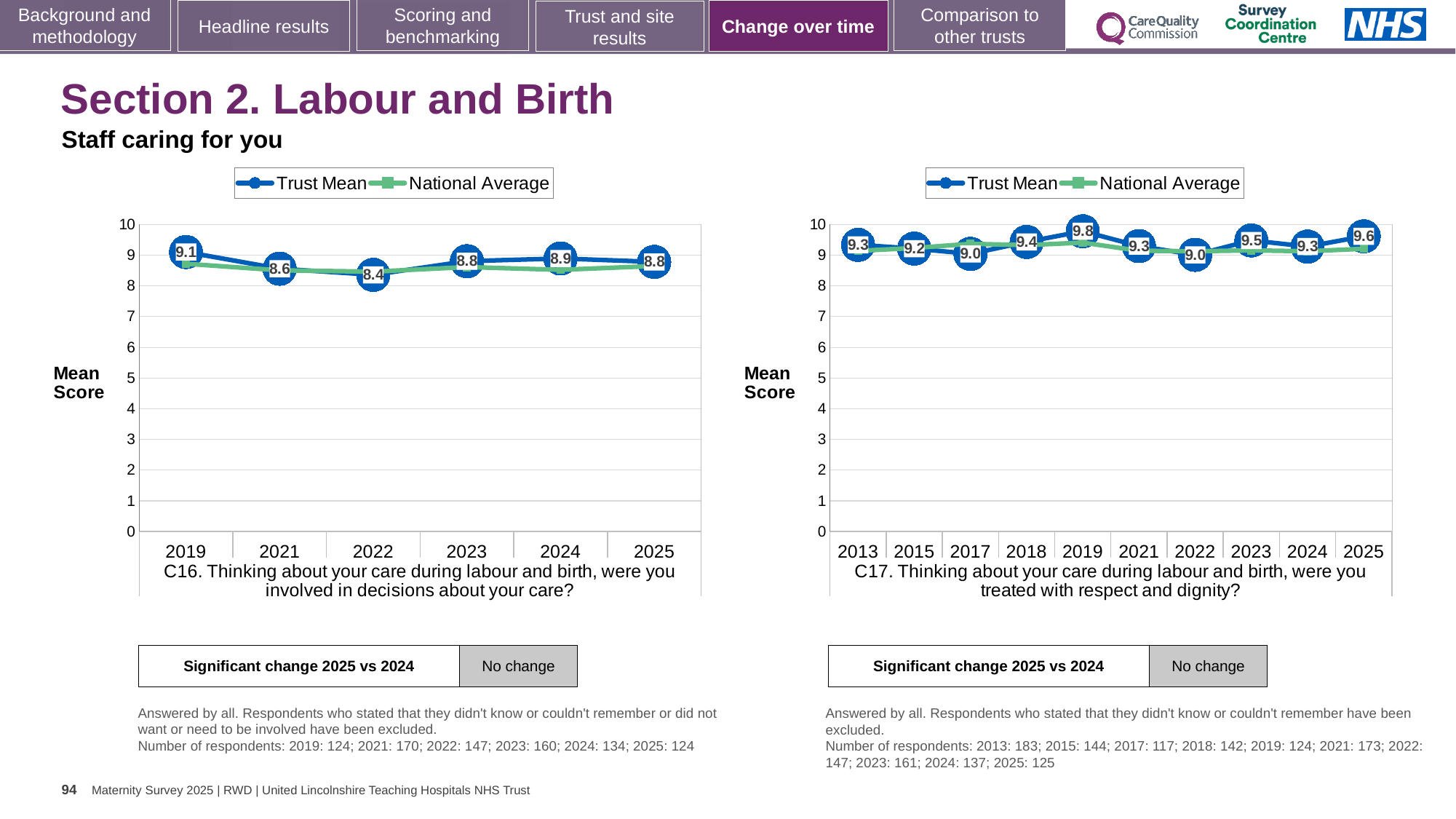
What type of chart is the C16 chart on the left? Line chart In the C17 chart (right), how many series does the legend list? 2 In the C17 chart (right), what is the Trust Mean for 2019? 9.8 In the C16 chart (left), which year has the lowest Trust Mean? 2022 In the C17 chart (right), what is the difference between the Trust Mean for 2025 and 2024? 0.3 In the C17 chart (right), which year has the highest Trust Mean? 2019 In the C16 chart (left), how many years are plotted on the x axis? 6 In the C16 chart (left), what is the difference between the Trust Mean for 2019 and 2022? 0.7 In the C16 chart (left), what is the Trust Mean for 2019? 9.1 In the C16 chart (left), what is the Trust Mean for 2022? 8.4 In the C17 chart (right), is the Trust Mean for 2018 larger or smaller than the Trust Mean for 2017? larger In the C16 chart (left), which year has the highest Trust Mean? 2019